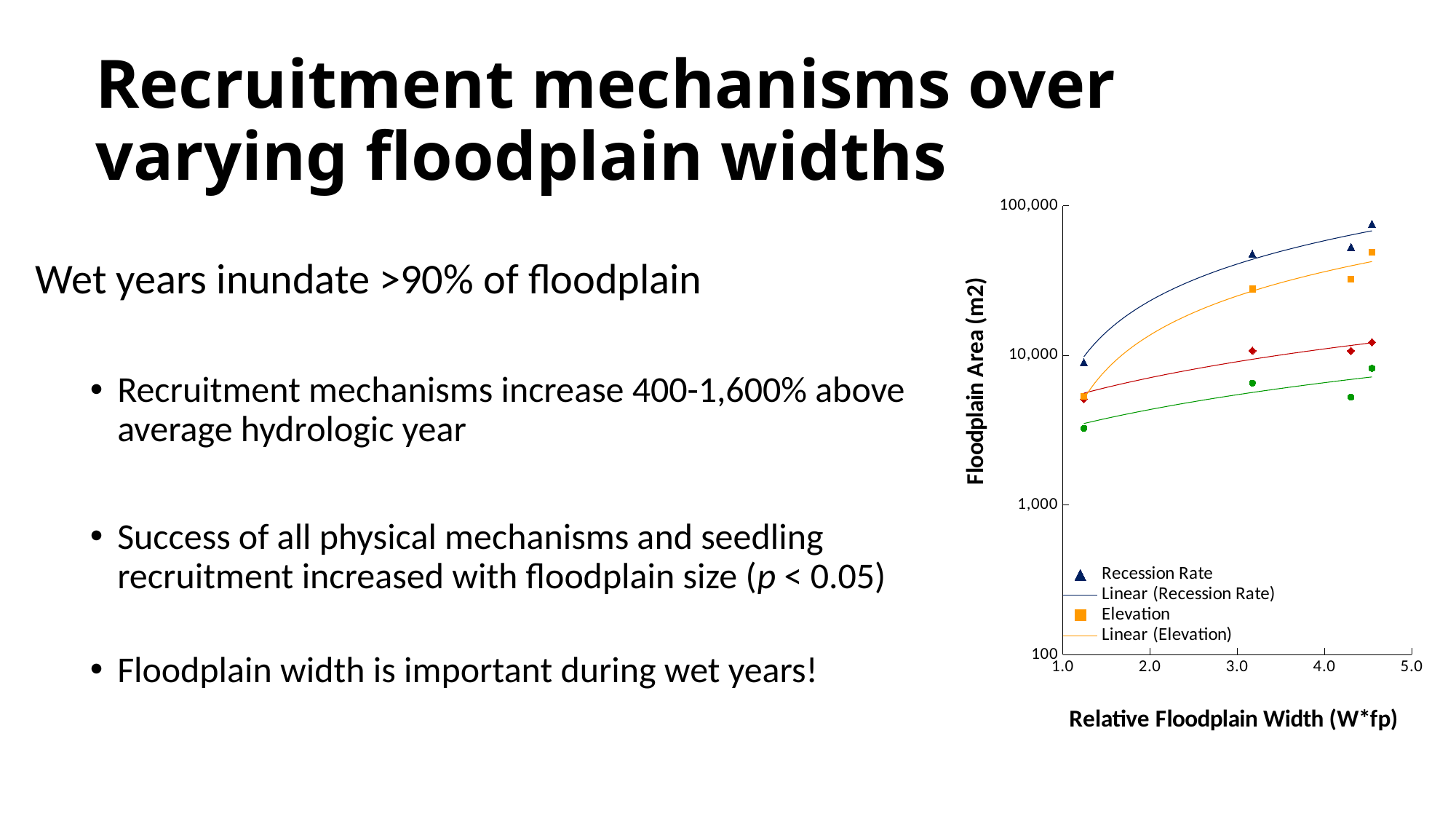
How many entries does the chart legend list? 4 Which series reaches the highest floodplain area on the chart? Recession Rate What kind of chart is shown on the slide? scatter chart How many Recession Rate data points are plotted on the chart? 4 Do the Recession Rate values rise or fall as relative floodplain width increases? rise Do the Elevation values rise or fall as relative floodplain width increases? rise What is the label of the chart's y axis? Floodplain Area (m2) Is the Recession Rate value at the largest floodplain width (about 4.5) greater or less than 10,000? greater At the largest floodplain width (about 4.5), which series has the higher floodplain area: Recession Rate or Elevation? Recession Rate Is the Elevation value at the smallest floodplain width (about 1.2) greater or less than 10,000? less What is the label of the chart's x axis? Relative Floodplain Width (W*fp) Is the Elevation value at a floodplain width of about 3.2 greater or less than 10,000? greater